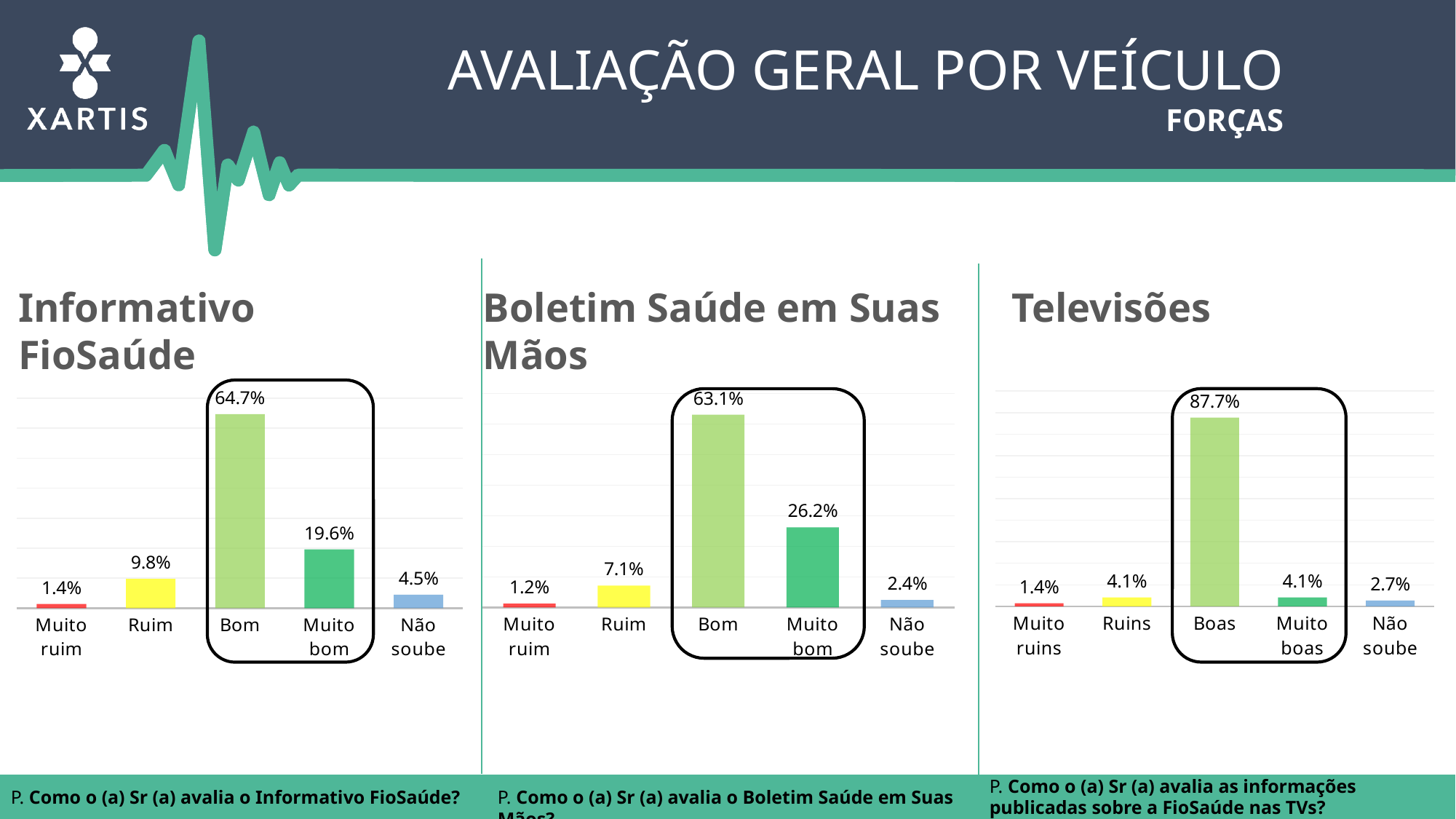
In the Boletim Saúde em Suas Mãos chart, what is the value for Muito bom? 26.2% In the Informativo FioSaúde chart, what is the difference between Bom and Muito bom? 45.1% In the Televisões chart, which category has the highest value? Boas In the Informativo FioSaúde chart, what is the value for Ruim? 9.8% In the Televisões chart, what is the combined value of Boas and Muito boas? 91.8% In the Televisões chart, what is the value for Não soube? 2.7% How many charts are shown on the slide? 3 In the Informativo FioSaúde chart, what is the value for Bom? 64.7% How many categories does the Televisões chart show? 5 What kind of chart is the Informativo FioSaúde chart? Bar chart In the Boletim Saúde em Suas Mãos chart, which category has the lowest value? Muito ruim In the Boletim Saúde em Suas Mãos chart, which is larger: Ruim or Não soube? Ruim